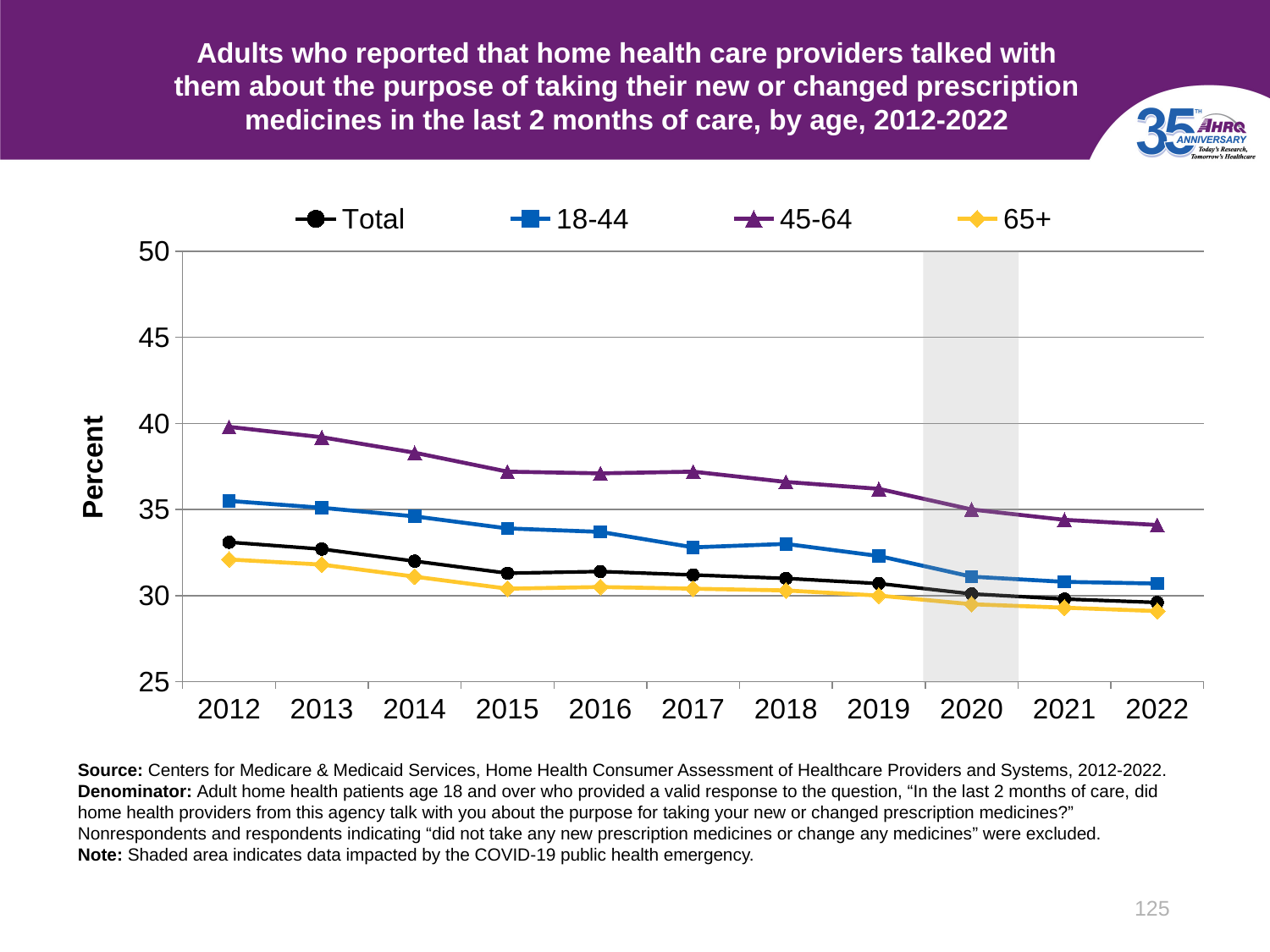
Is the value for Total in 2015 greater or less than 30? greater Is the value for 45-64 in 2022 greater or less than 35? less In 2018, which is larger: the value for 18-44 or the value for Total? 18-44 How many years are plotted along the x axis? 11 What kind of chart is shown on the slide? Line chart Which age group has the lowest value in 2012? 65+ Does the value for 45-64 rise or fall from 2012 to 2022? Fall Which age group has the highest value in 2022? 45-64 Is the value for 18-44 in 2012 greater or less than 35? greater According to the note, what does the shaded area on the chart indicate? Data impacted by the COVID-19 public health emergency How many series does the legend list? 4